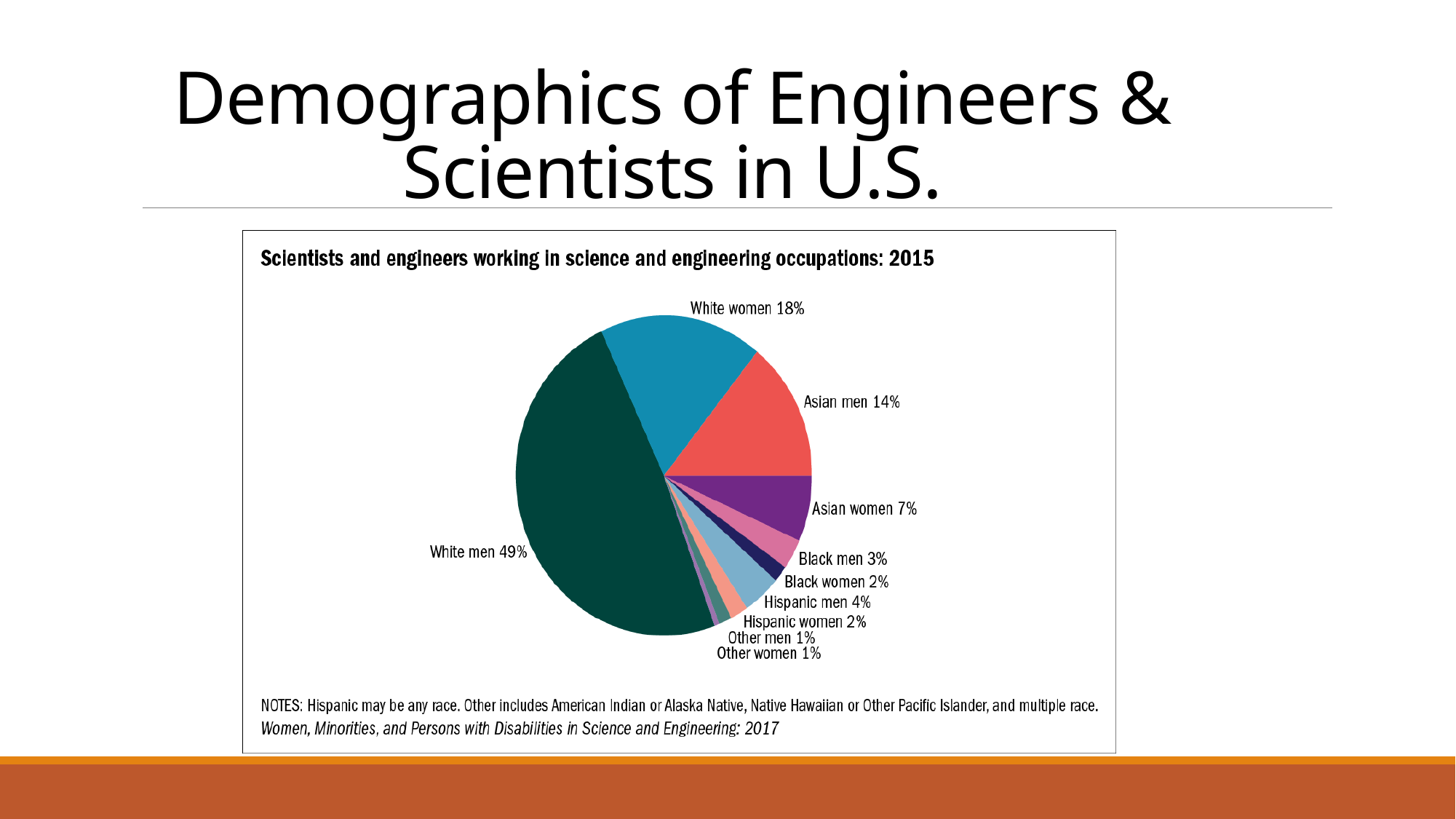
What is the combined share of Black men and Black women in the pie chart? 5% What is the difference in percentage points between the White men slice and the White women slice? 31 What percentage of the pie chart is labelled Asian men? 14% What share of scientists and engineers working in science and engineering occupations in 2015 are White men? 49% Which group has the larger share in the pie chart, White women or Asian women? White women Which group has the larger share in the pie chart, Hispanic men or Black men? Hispanic men How many slices does the pie chart have? 10 What is the value shown for Hispanic men in the pie chart? 4% What is the difference in percentage points between Asian men and Asian women in the pie chart? 7 Which group has the largest slice of the pie chart? White men What is the title of the chart on the slide? Scientists and engineers working in science and engineering occupations: 2015 What kind of chart is shown on the slide? Pie chart